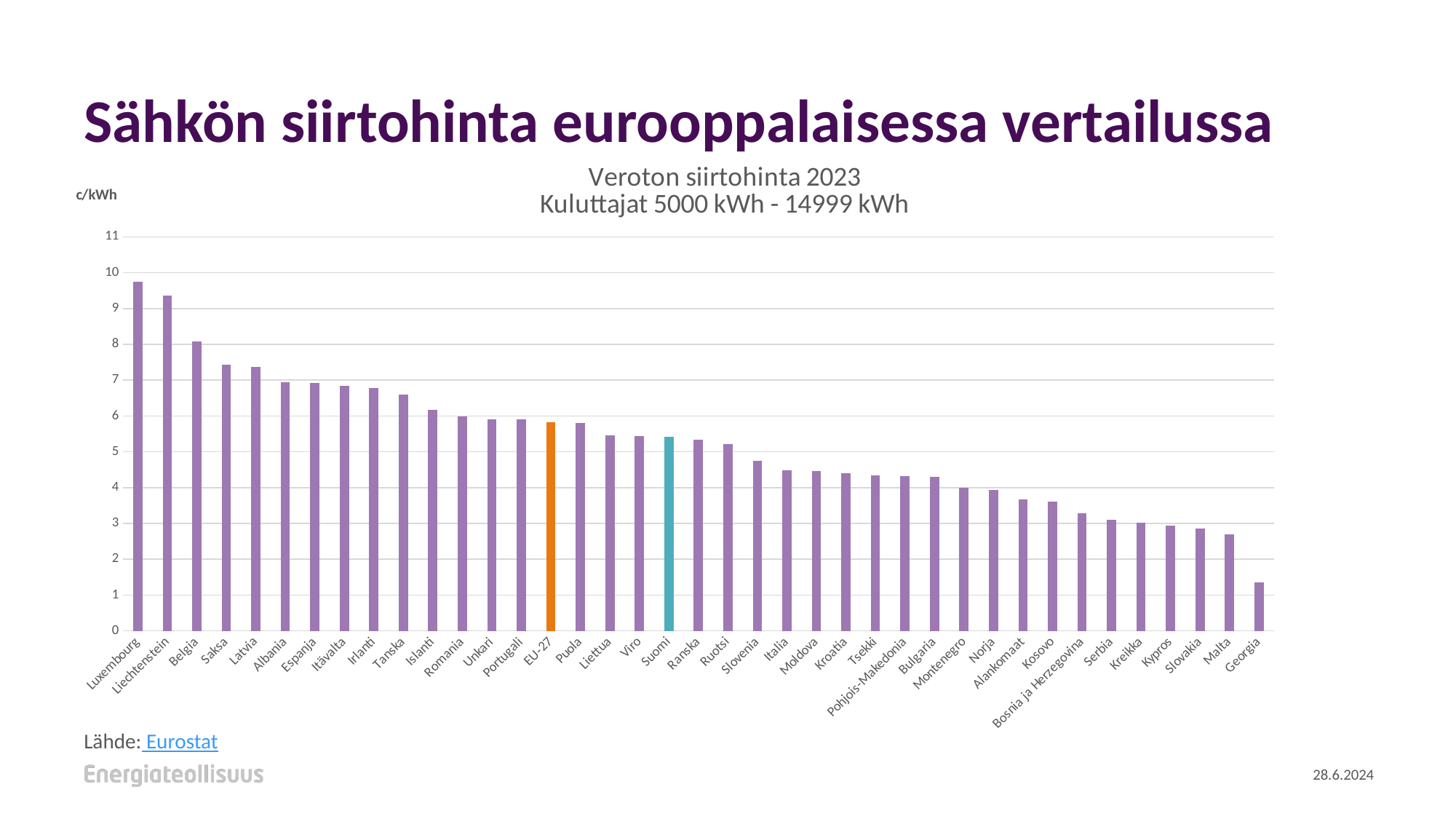
Is the value for EU-27 greater or less than 6? less Which country has the lowest transmission price in the chart? Georgia Is the value for Malta greater or less than 3? less Which has the larger value, Suomi or Italia? Suomi What unit is shown on the vertical axis of the chart? c/kWh What kind of chart is shown on the slide? bar chart Do the values rise or fall from left to right along the x axis? fall Is the value for Luxembourg greater or less than 9? greater Which country has the highest transmission price in the chart? Luxembourg How many bars (countries and EU-27) are shown in the chart? 39